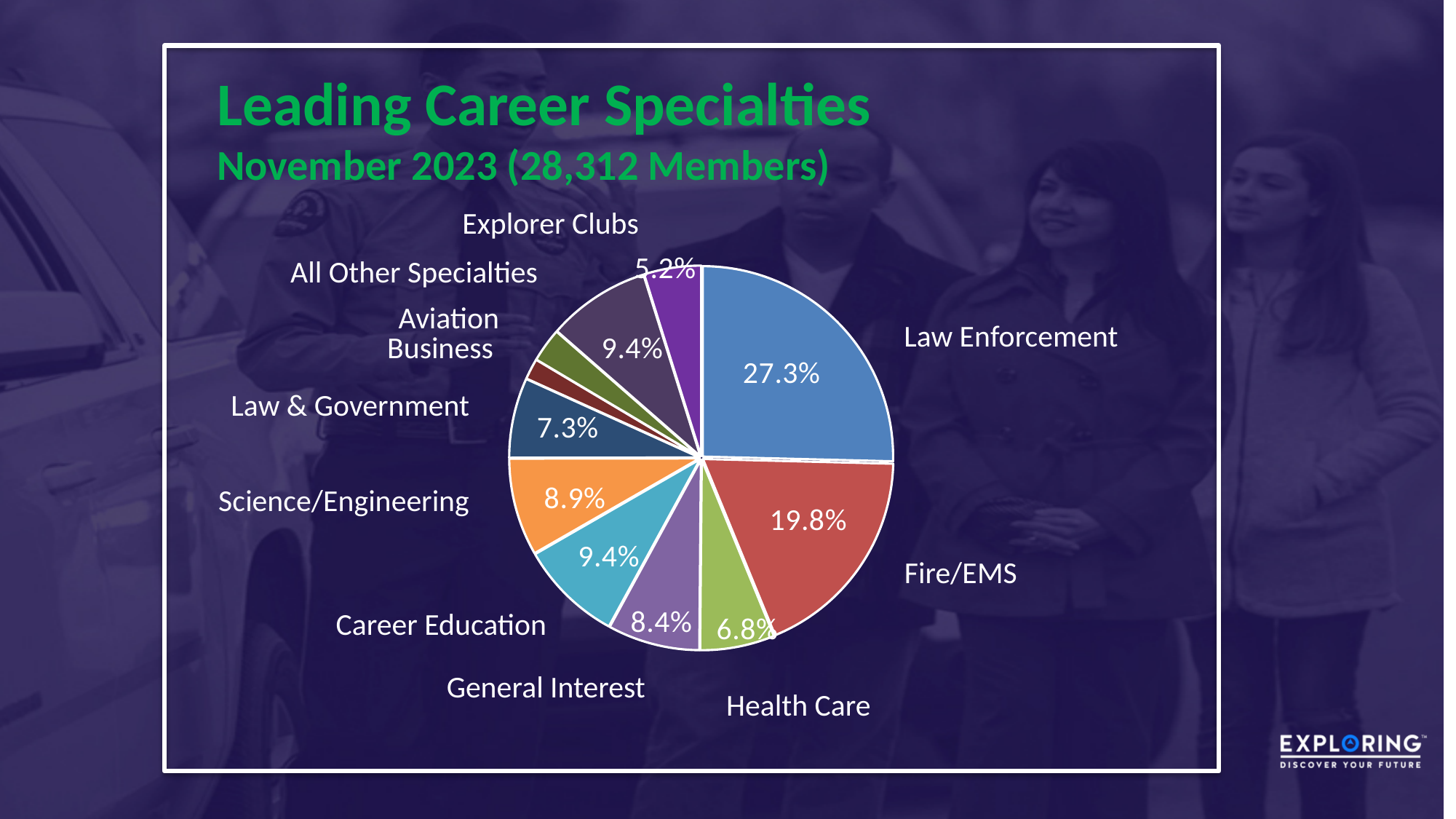
What share of members is in Law Enforcement? 27.3% What kind of chart is shown on the slide? pie chart What is the title of the chart? Leading Career Specialties Which has a larger share, Health Care or Law & Government? Law & Government Which career specialty has the largest slice of the pie? Law Enforcement What percentage is shown for Science/Engineering? 8.9% What percentage is shown for Fire/EMS? 19.8% Which has a larger share, Career Education or General Interest? Career Education What percentage is shown for Law & Government? 7.3% How many slices does the pie chart have? 11 What percentage is shown for Health Care? 6.8% What is the difference in percentage points between Law Enforcement and Fire/EMS? 7.5%